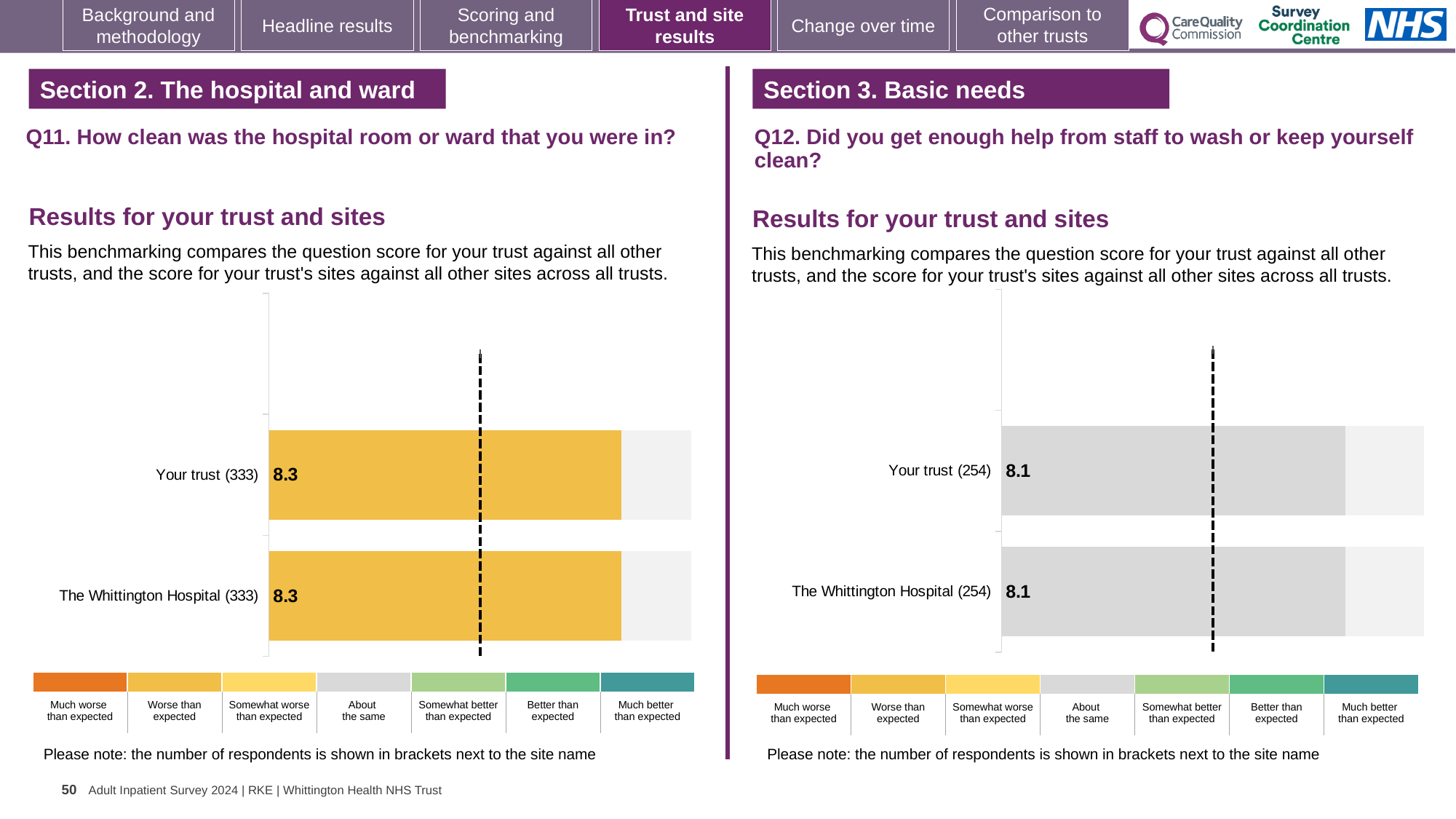
In the Q11 chart (left), how many respondents are shown in brackets for Your trust? 333 What kind of chart is used for the Q11 results (left)? Bar chart In the Q11 chart (left), what is the score for Your trust (333)? 8.3 In the Q12 chart (right), what is the score for The Whittington Hospital (254)? 8.1 Is the score for Your trust in the Q12 chart (right) greater or less than the score for Your trust in the Q11 chart (left)? less In the Q12 chart (right), what is the score for Your trust (254)? 8.1 How many bars are plotted in the Q11 chart (left)? 2 How many bars are plotted in the Q12 chart (right)? 2 In the Q11 chart (left), what is the difference between the score for Your trust and the score for The Whittington Hospital? 0.0 In the Q12 chart (right), which benchmark category does the grey colour of the bars correspond to in the legend? About the same In the Q11 chart (left), what is the score for The Whittington Hospital (333)? 8.3 In the Q12 chart (right), what is the difference between the score for Your trust and the score for The Whittington Hospital? 0.0